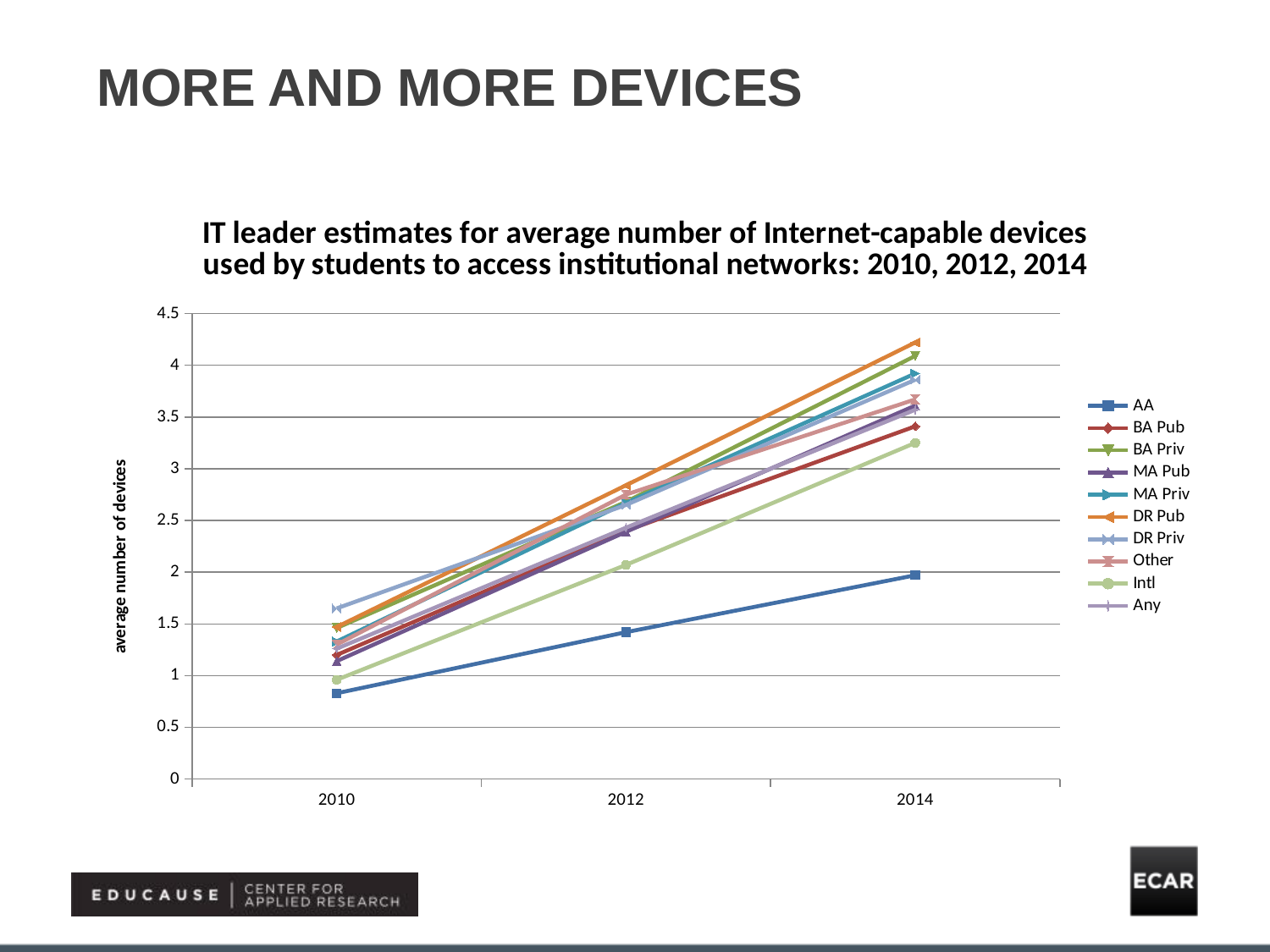
Which series has the lowest value in 2014? AA Is the value for Intl in 2014 greater or less than 3? greater Is the value for DR Pub in 2014 greater or less than 4? greater How many series does the legend list? 10 In 2014, which is larger: the value for DR Pub or the value for BA Pub? DR Pub Is the value for AA in 2010 greater or less than 1? less How many years are plotted along the x axis? 3 Which series has the highest value in 2010? DR Priv What kind of chart is shown on the slide? line chart Which series has the lowest value in 2010? AA What is the label on the y axis? average number of devices Do the values for the DR Pub series rise or fall from 2010 to 2014? rise